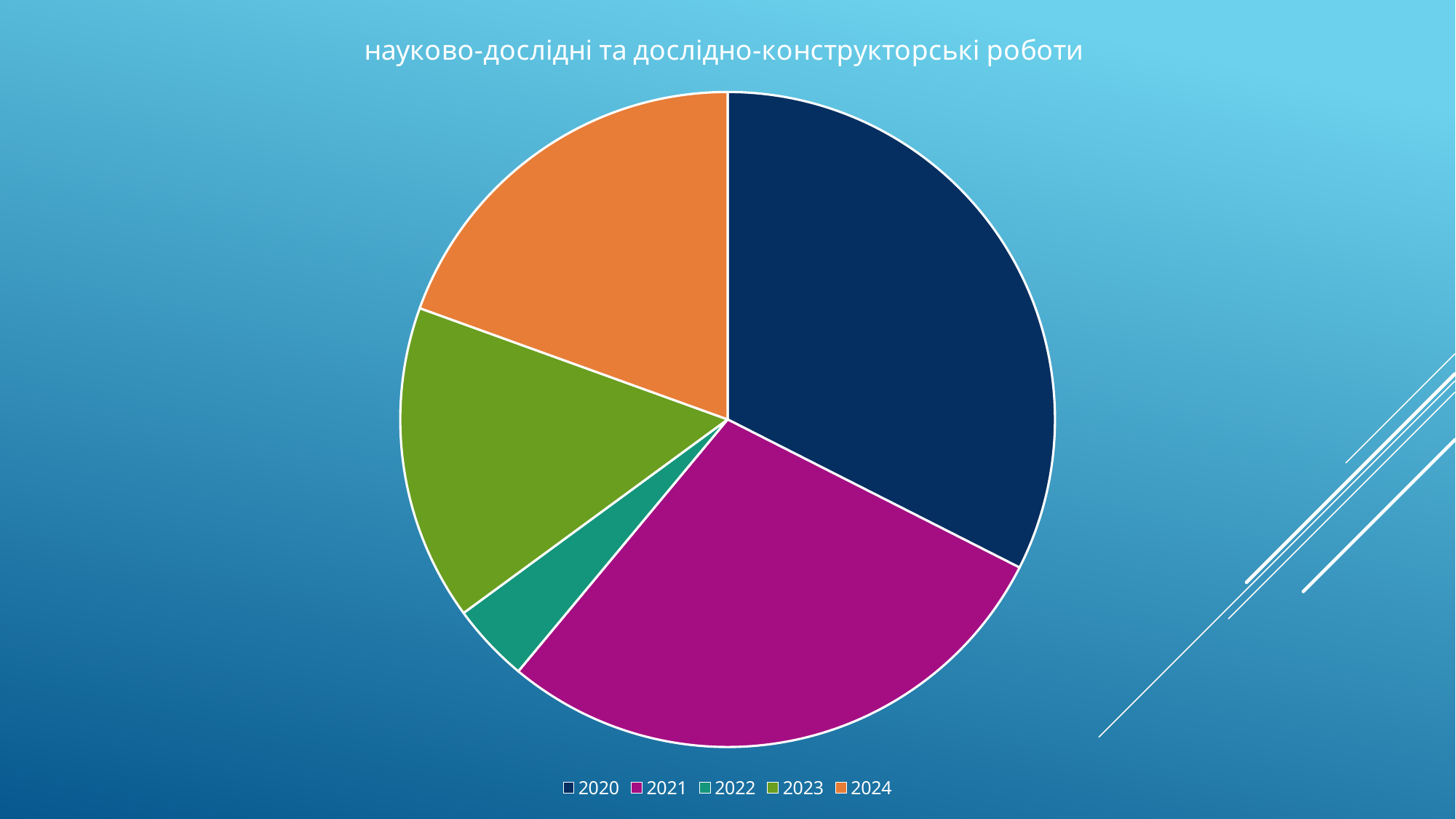
Which year has the largest slice of the pie? 2020 What is the title of the chart? науково-дослідні та дослідно-конструкторські роботи What kind of chart is shown on the slide? pie chart Which year has the smallest slice of the pie? 2022 Which slice is larger, 2023 or 2022? 2023 How many slices does the pie chart have? 5 Which slice is larger, 2024 or 2023? 2024 Which year is shown in orange in the legend? 2024 How many entries does the legend list? 5 Which slice is larger, 2020 or 2021? 2020